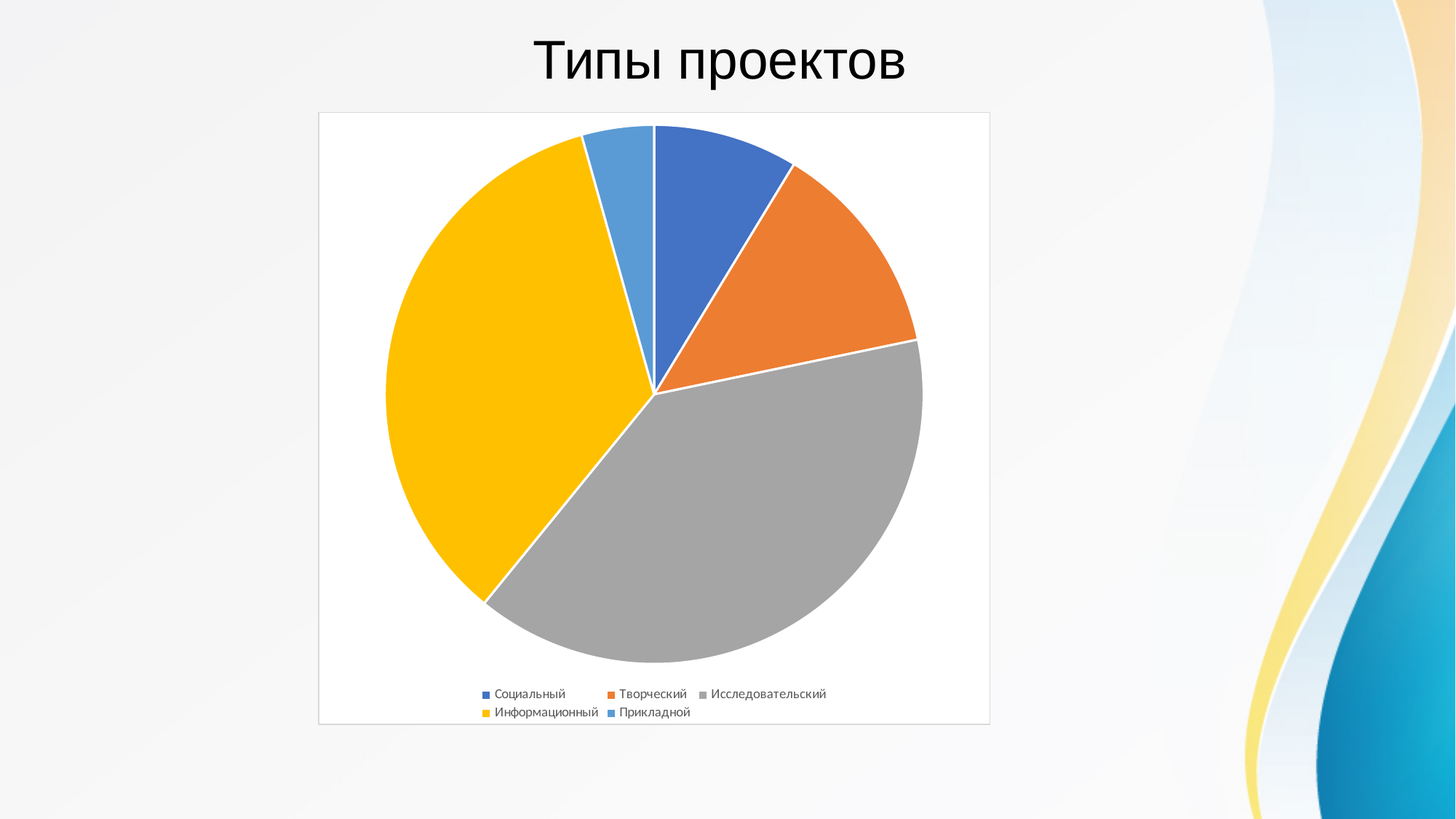
Which slice is larger, Исследовательский or Информационный? Исследовательский Which slice is larger, Социальный or Прикладной? Социальный Which slice is larger, Творческий or Социальный? Творческий What kind of chart is shown on the slide? pie chart Which category is shown in yellow in the pie chart? Информационный How many categories does the pie chart show? 5 Which category has the smallest slice of the pie? Прикладной Which category has the largest slice of the pie? Исследовательский What is the title of the slide containing the pie chart? Типы проектов